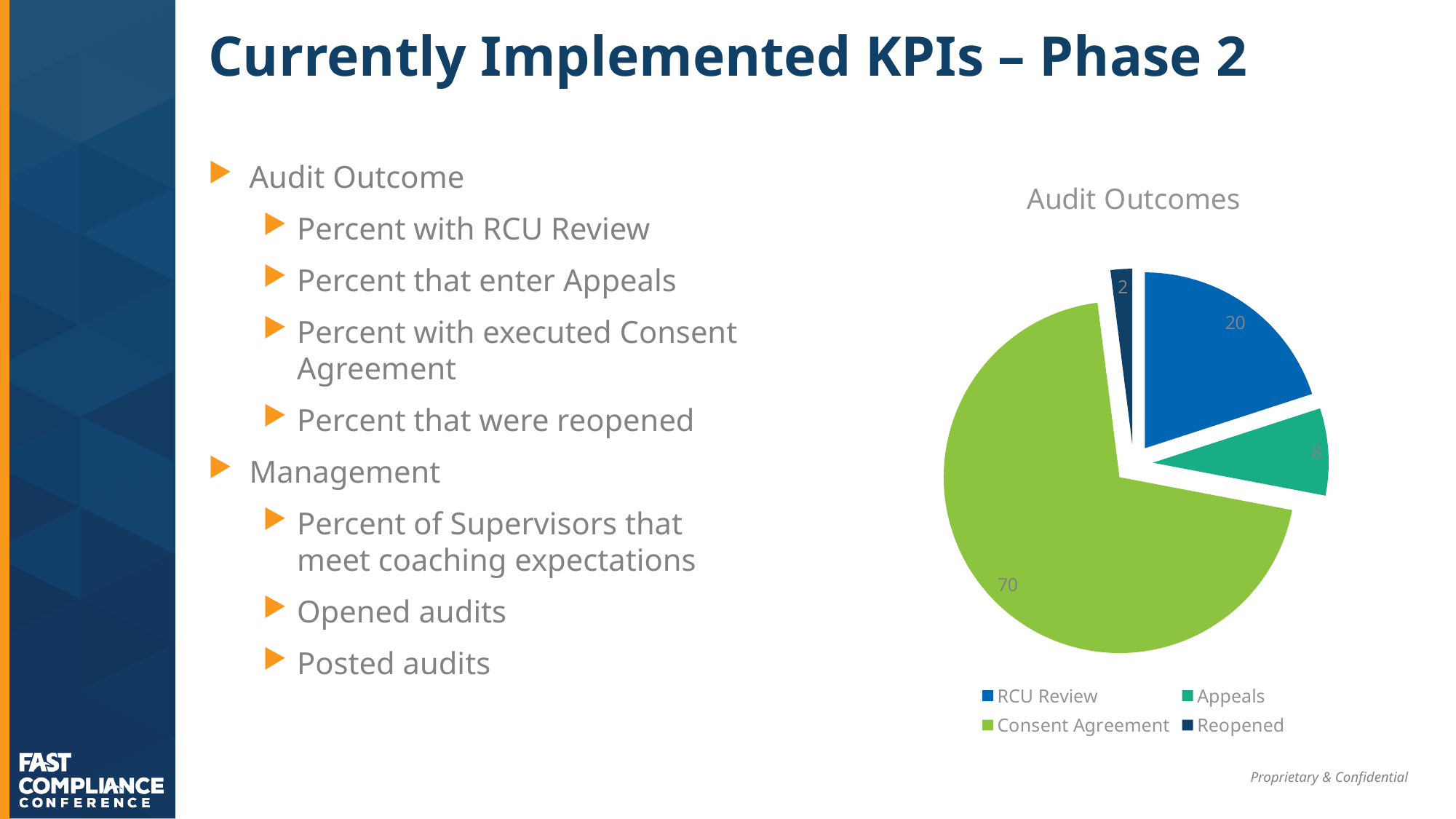
What is the title of the chart on the slide? Audit Outcomes Which category has the largest slice in the Audit Outcomes pie chart? Consent Agreement What is the value for Reopened in the Audit Outcomes pie chart? 2 What kind of chart is shown on the slide? Pie chart What is the value for RCU Review in the Audit Outcomes pie chart? 20 What is the value for Appeals in the Audit Outcomes pie chart? 8 Which category has the smallest slice in the Audit Outcomes pie chart? Reopened How many categories are shown in the Audit Outcomes pie chart? 4 What is the difference between the Consent Agreement and RCU Review values in the Audit Outcomes pie chart? 50 Which is larger in the Audit Outcomes pie chart, RCU Review or Appeals? RCU Review What share of the Audit Outcomes pie does Consent Agreement represent? 70% What is the value for Consent Agreement in the Audit Outcomes pie chart? 70